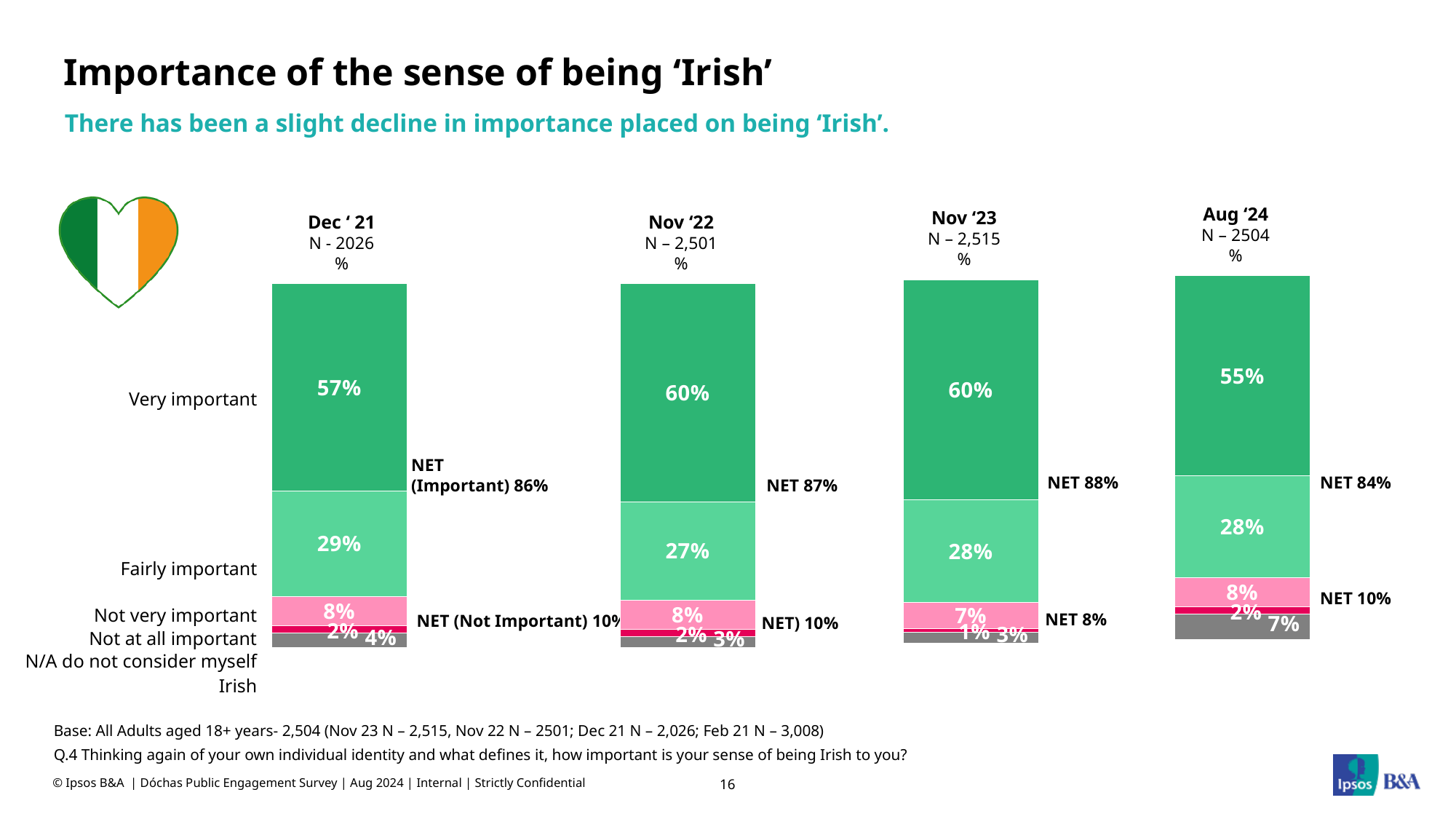
Which wave has the highest NET (Important) figure? Nov '23 Is the 'Fairly important' share larger in Dec '21 or in Nov '22? Dec '21 What is the difference between the 'Very important' share in Nov '22 and in Aug '24? 5 percentage points What is the sample size (N) shown for the Nov '22 wave? N – 2,501 How many survey waves are shown in the chart? 4 In which wave was the 'Very important' share lowest? Aug '24 What type of chart is shown on the slide? Stacked bar chart What percentage said being Irish was 'Very important' in Aug '24? 55% What percentage said being Irish was 'Fairly important' in Dec '21? 29% What is the NET (Important) figure for Nov '23? NET 88% What is the NET (Not Important) figure for Nov '23? NET 8% What percentage answered 'N/A do not consider myself Irish' in Aug '24? 7%